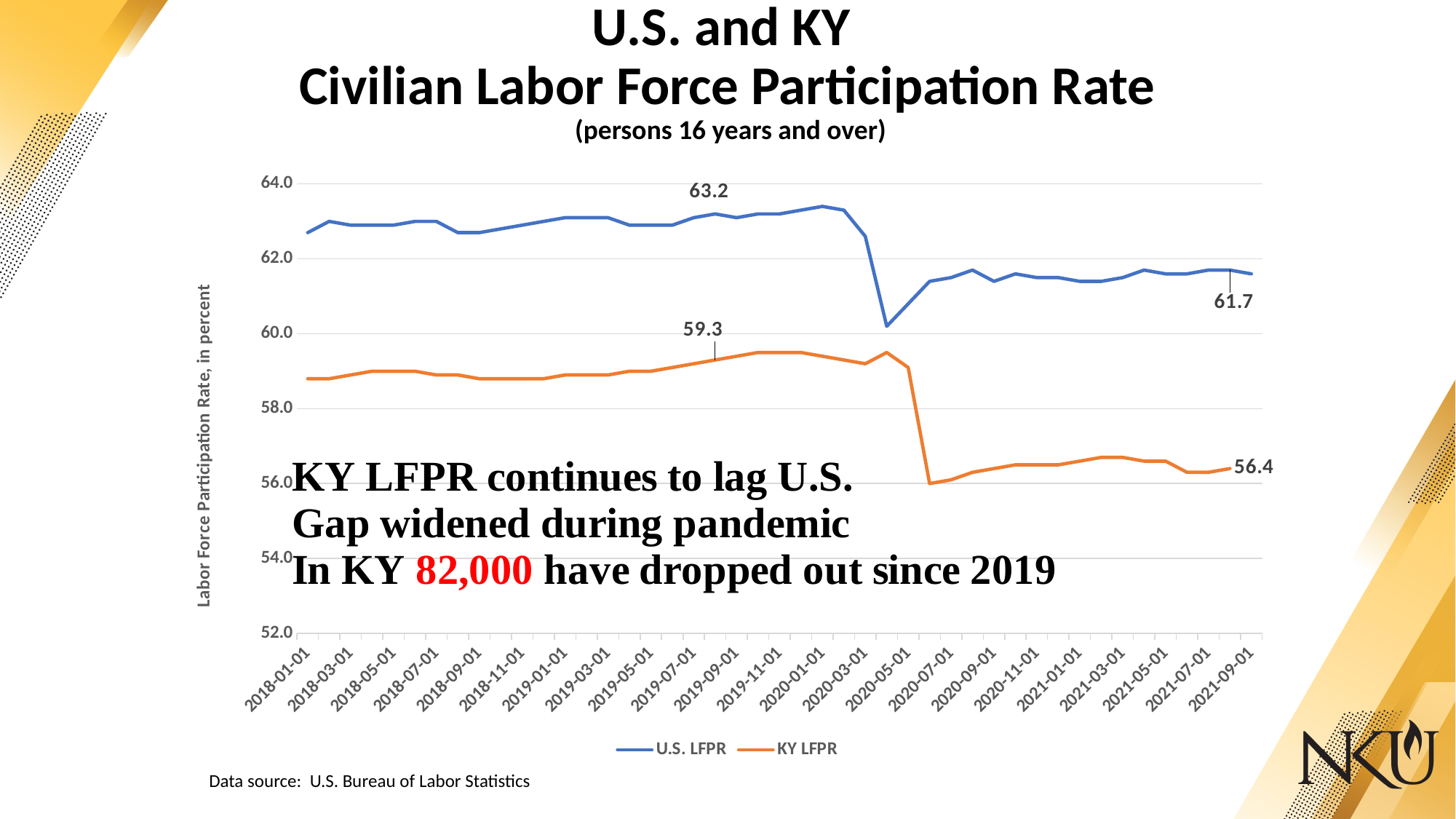
Is the U.S. LFPR value at 2018-01-01 greater or less than 62.0? greater Which series has the higher value at 2021-09-01, U.S. LFPR or KY LFPR? U.S. LFPR Is the KY LFPR value at 2020-07-01 greater or less than 58.0? less What value is labeled on the U.S. LFPR line near 2019-09-01? 63.2 What value is labeled on the KY LFPR line near 2019-09-01? 59.3 What is the U.S. LFPR value labeled at 2021-09-01? 61.7 What is the difference between the labeled U.S. LFPR (61.7) and KY LFPR (56.4) values at 2021-09-01? 5.3 What kind of chart is shown on the slide? Line chart How many series does the legend list? 2 What is the title of the vertical axis? Labor Force Participation Rate, in percent What is the KY LFPR value labeled at 2021-09-01? 56.4 Does the KY LFPR line rise or fall between 2020-03-01 and 2020-07-01? Fall